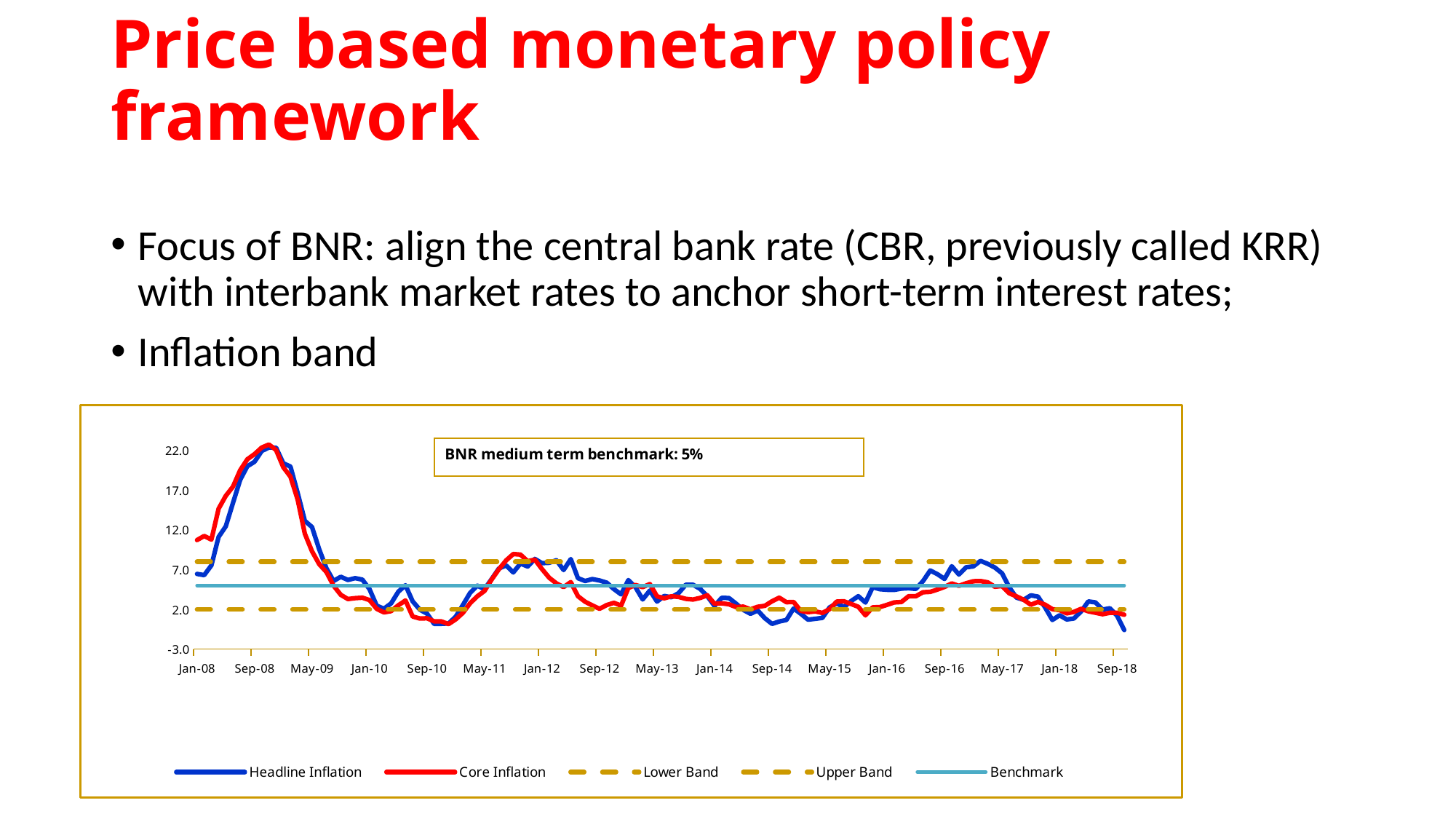
Is the Headline Inflation value at Jan-14 greater or less than 7.0? less Which two series in the legend are drawn as dashed lines? Lower Band and Upper Band Is the Headline Inflation value at Sep-08 greater or less than 17.0? greater Does the Headline Inflation line rise or fall between Sep-08 and May-09? fall How many series does the chart legend list? 5 Is the Core Inflation value at Jan-08 greater or less than 7.0? greater How many date labels are shown on the x axis of the chart? 17 What is the last date label on the x axis of the chart? Sep-18 What type of chart is shown on the slide? line chart What value does the text box on the chart give for the BNR medium term benchmark? 5%